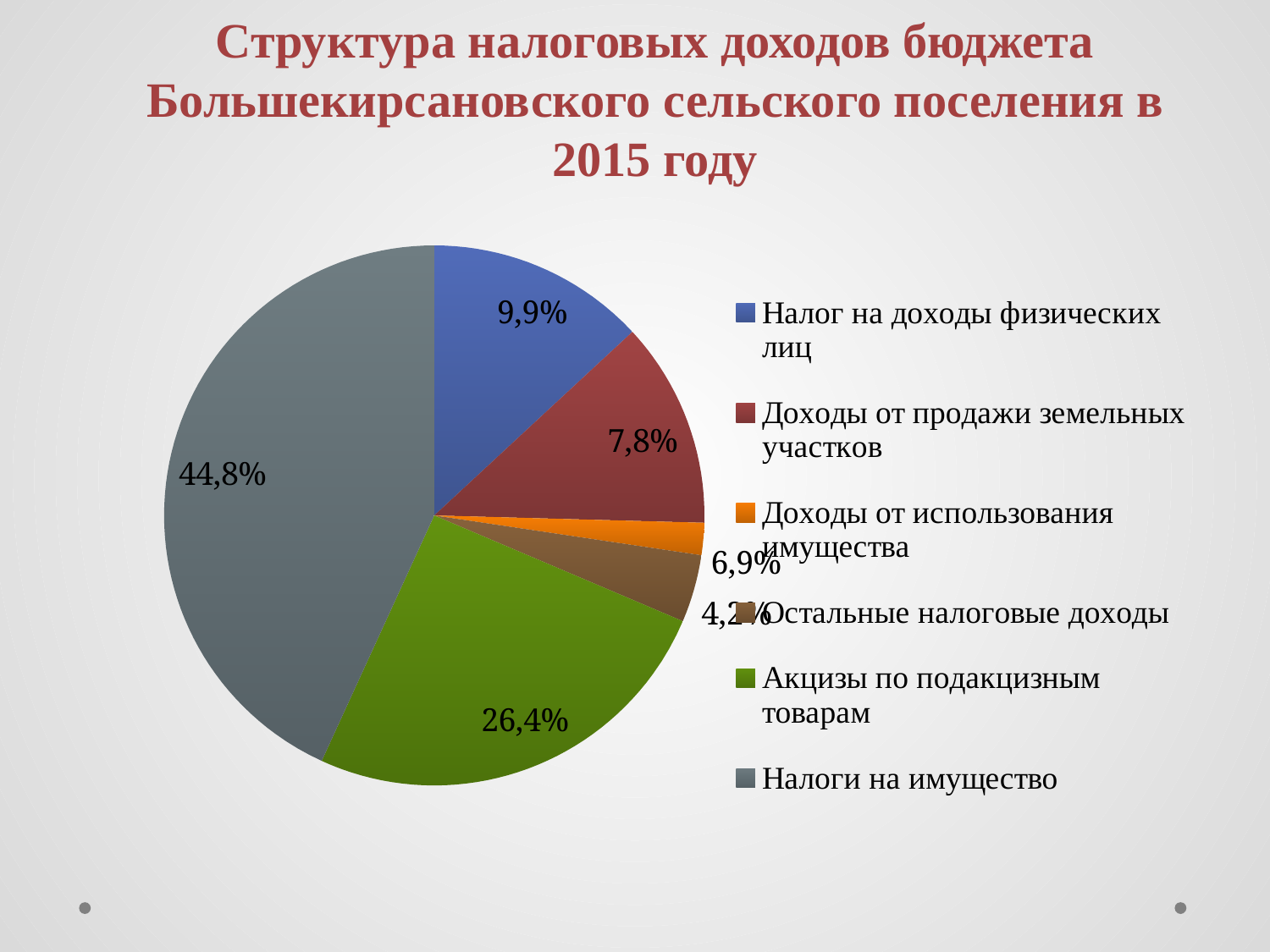
What kind of chart is shown on the slide? pie chart What share is shown for "Акцизы по подакцизным товарам"? 26,4% Which year does the chart title refer to? 2015 What share is shown for "Доходы от продажи земельных участков"? 7,8% What is the combined share of "Налоги на имущество" and "Акцизы по подакцизным товарам"? 71,2% How many entries does the legend list? 6 What share of tax revenues does "Налоги на имущество" account for? 44,8% How many slices does the pie chart have? 6 By how many percentage points does the share of "Налоги на имущество" exceed that of "Акцизы по подакцизным товарам"? 18,4 Which is larger: the share for "Налог на доходы физических лиц" or for "Доходы от продажи земельных участков"? Налог на доходы физических лиц Which category has the largest share of the pie? Налоги на имущество What share is shown for "Налог на доходы физических лиц"? 9,9%